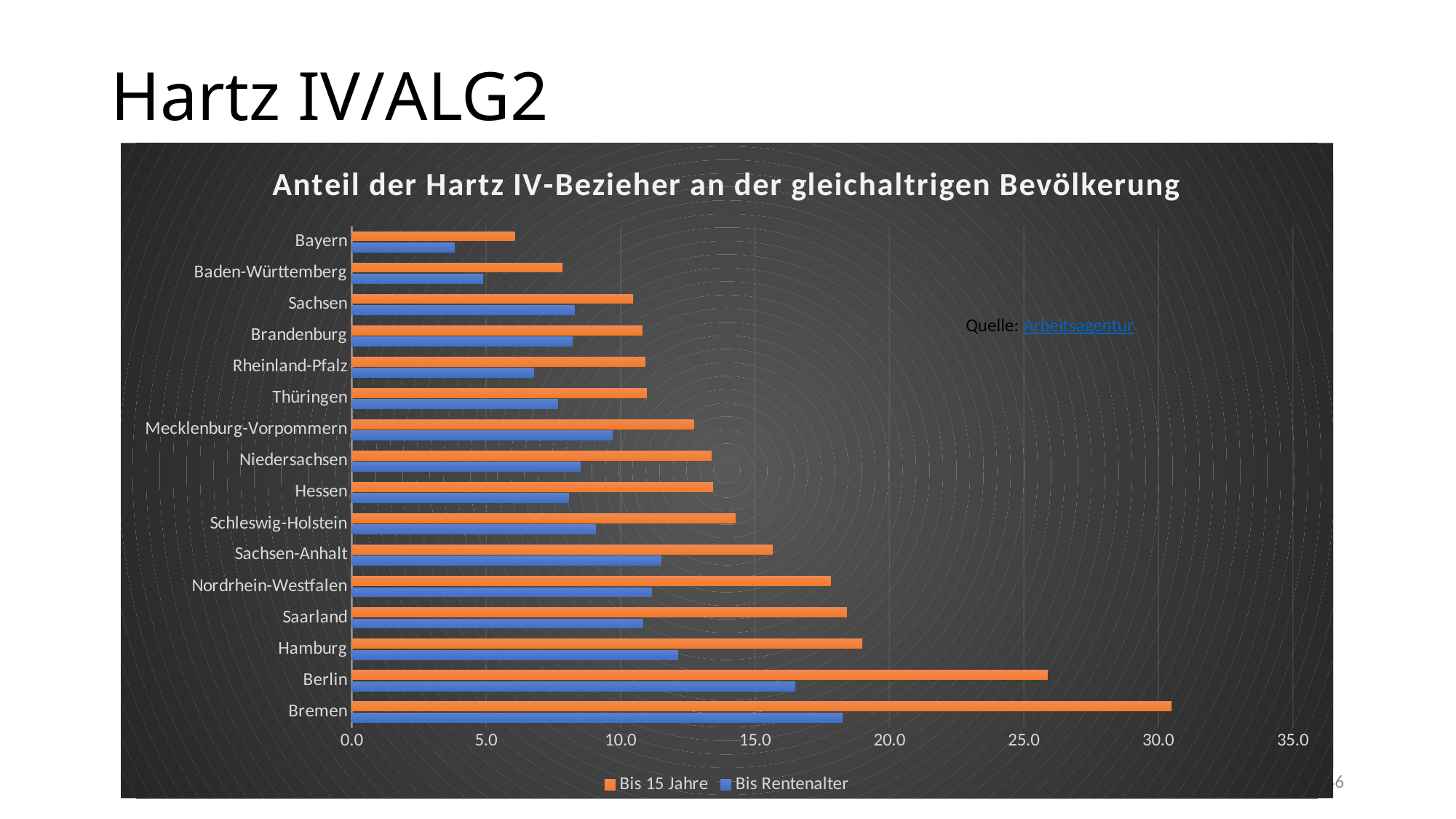
How many series does the legend list? 2 Which state has the highest value for 'Bis Rentenalter'? Bremen How many federal states (categories) are shown on the chart? 16 Which state has the highest value for 'Bis 15 Jahre'? Bremen Is the 'Bis 15 Jahre' value for Bayern greater or less than 10.0? less What is the title of the chart? Anteil der Hartz IV-Bezieher an der gleichaltrigen Bevölkerung Is the 'Bis 15 Jahre' value for Nordrhein-Westfalen greater or less than 20.0? less Which state has the lowest value for 'Bis 15 Jahre'? Bayern Is the 'Bis Rentenalter' value for Hamburg greater or less than 10.0? greater Which has the larger 'Bis 15 Jahre' value, Berlin or Hamburg? Berlin What kind of chart is shown on the slide? bar chart